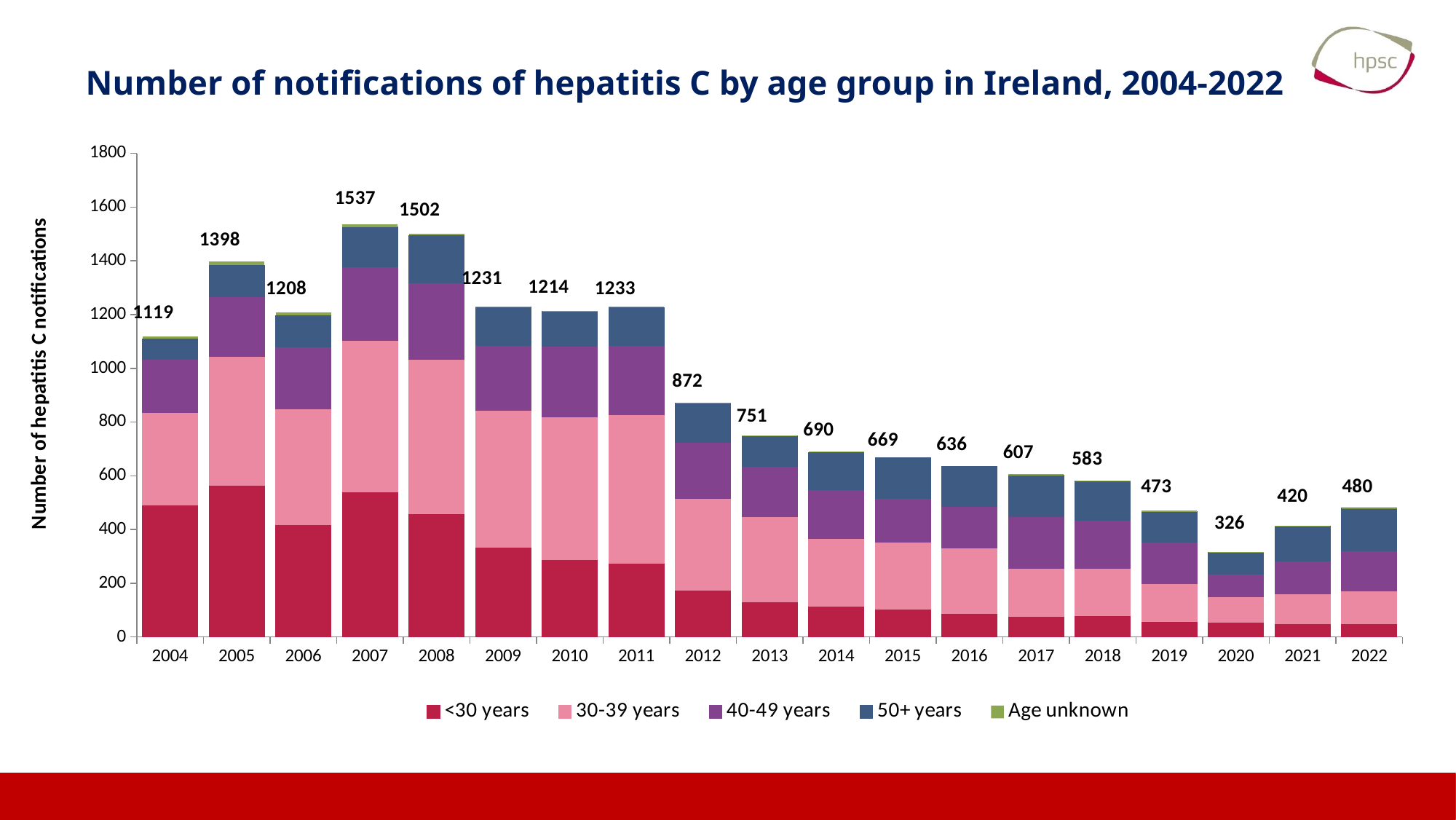
What is the total number of hepatitis C notifications in 2022? 480 What is the total number of hepatitis C notifications in 2020? 326 Which year has more total notifications, 2012 or 2013? 2012 Which year has the highest total number of notifications? 2007 How many age group series does the legend list? 5 Which year has the lowest total number of notifications? 2020 What kind of chart is shown on the slide? Stacked bar chart What is the difference between the total notifications in 2007 and 2008? 35 Is the value for the <30 years group in 2005 greater or less than 400? greater How many years are shown on the x axis? 19 What is the difference between the total notifications in 2022 and 2021? 60 What is the total number of hepatitis C notifications in 2007? 1537